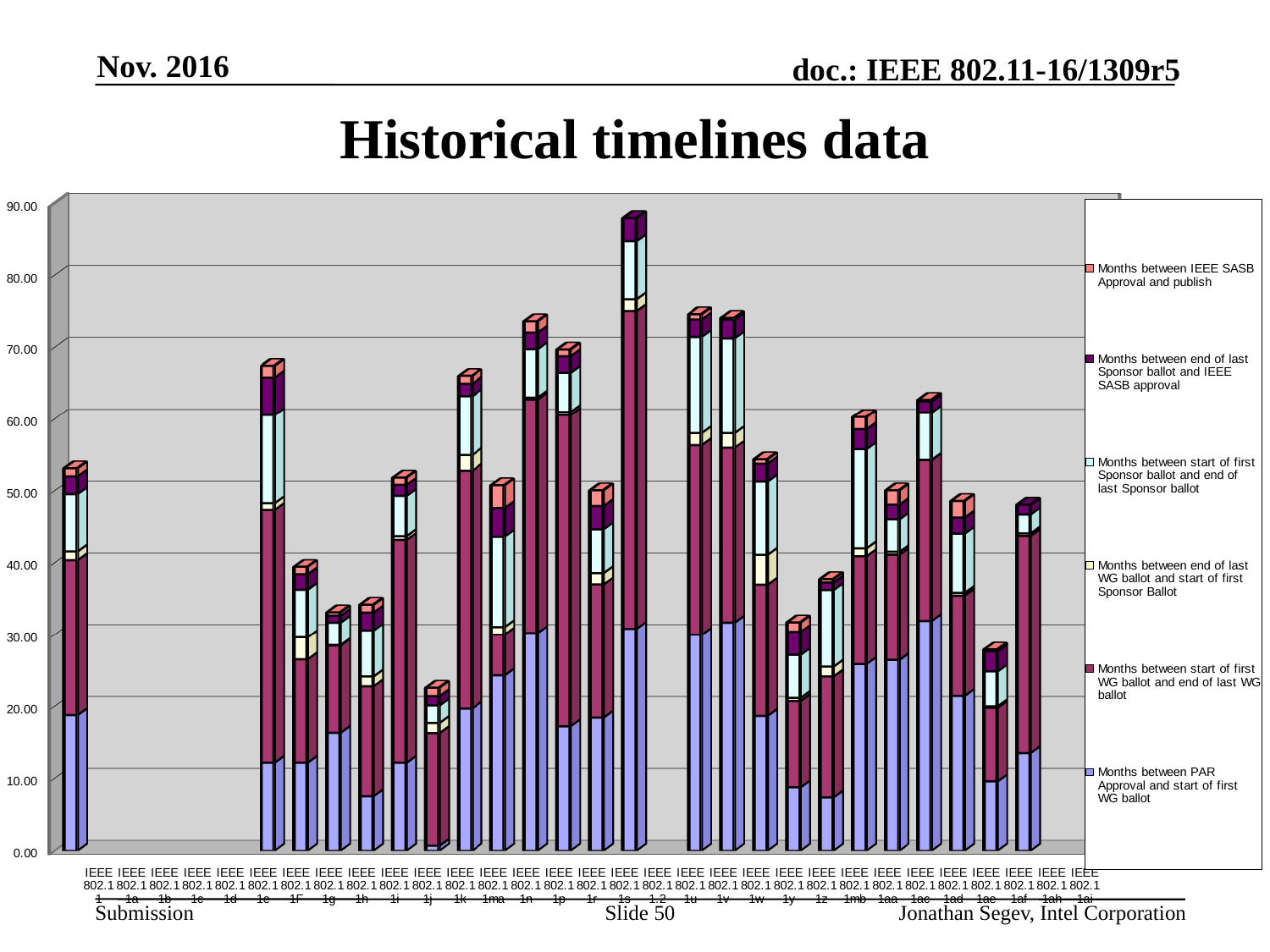
What kind of chart is shown on the slide? bar chart Is the total of the first (leftmost) stacked bar greater or less than 50? greater Is the total of the first (leftmost) stacked bar greater or less than 60? less How many series does the legend list? 6 What is the highest value shown on the y axis? 90.00 Is the total of the tallest stacked bar greater or less than 80? greater Which series forms the bottom segment of each stacked bar, according to the legend? Months between PAR Approval and start of first WG ballot Which series is listed at the top of the legend? Months between IEEE SASB Approval and publish